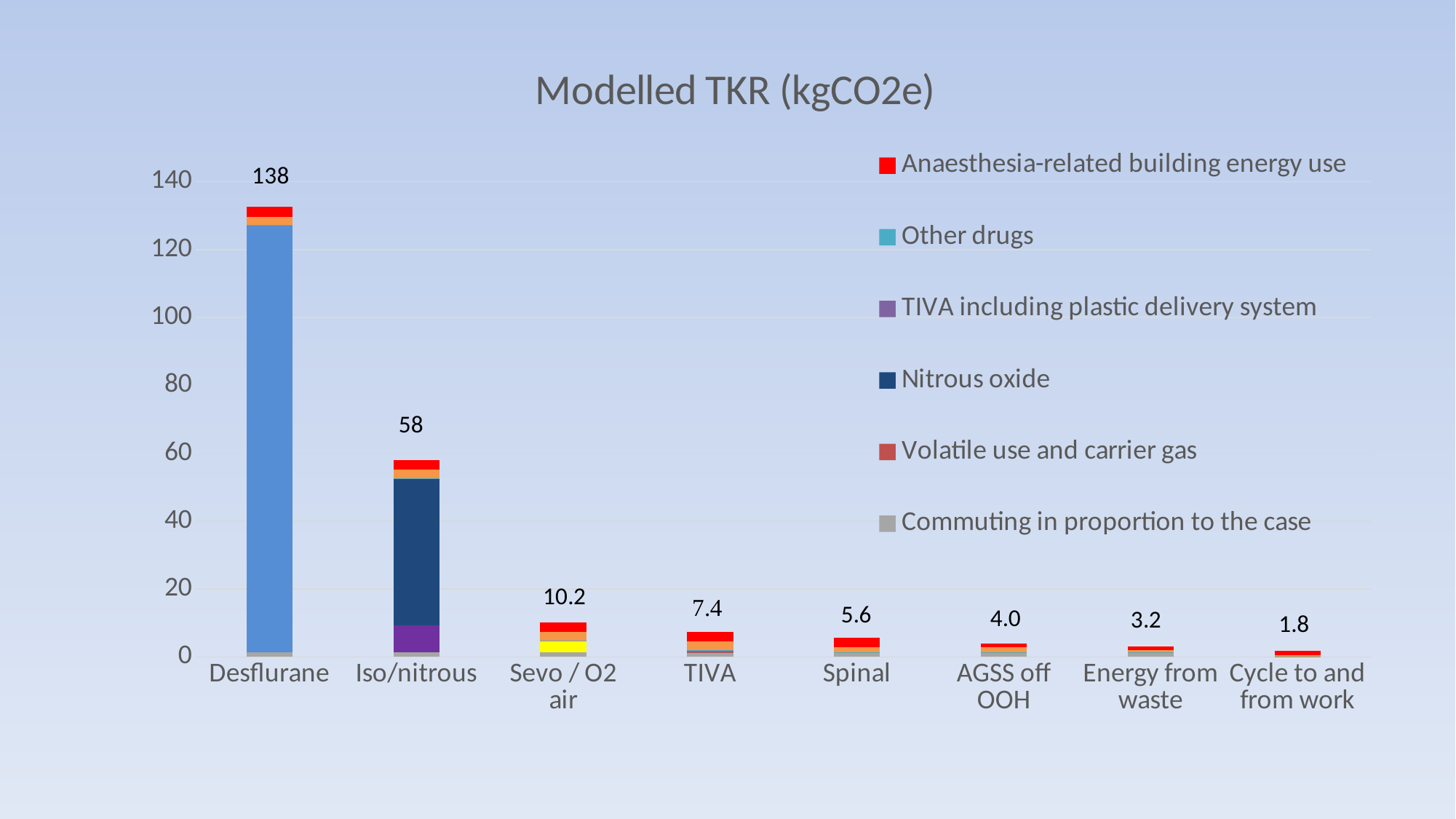
Which has a larger total, TIVA or Spinal? TIVA How many categories are shown on the x axis? 8 Which category has the highest total? Desflurane What is the title of the chart? Modelled TKR (kgCO2e) What is the total value labelled for Cycle to and from work? 1.8 Which category has the lowest total? Cycle to and from work What is the total value labelled for Iso/nitrous? 58 What is the total value labelled for Sevo / O2 air? 10.2 How many series does the legend list? 6 What is the total value labelled for Desflurane? 138 Is the total for Iso/nitrous greater or less than 60? less What is the difference between the totals for Desflurane and Iso/nitrous? 80